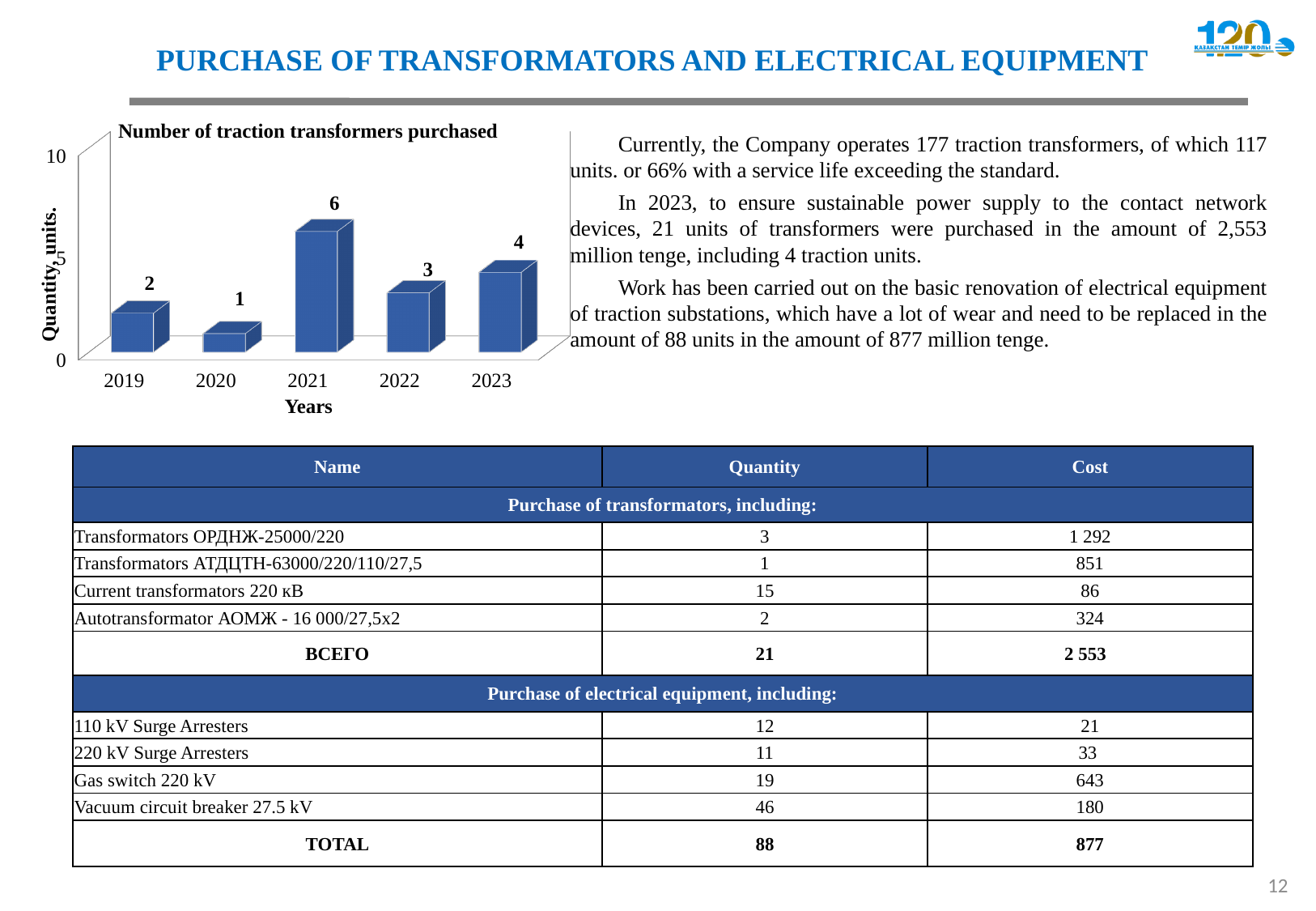
What kind of chart is used to show the number of traction transformers purchased? bar chart What is the difference between the number of traction transformers purchased in 2021 and in 2022? 3 What is the label of the vertical axis of the chart? Quantity, units. What is the number of traction transformers purchased in 2019? 2 How many years are shown on the x axis of the chart? 5 What is the title of the chart? Number of traction transformers purchased What is the number of traction transformers purchased in 2023? 4 Is the number of traction transformers purchased in 2021 greater or less than 5? greater What is the number of traction transformers purchased in 2021? 6 Which year has the highest number of traction transformers purchased? 2021 Which year has the lowest number of traction transformers purchased? 2020 Which year had more traction transformers purchased, 2019 or 2023? 2023